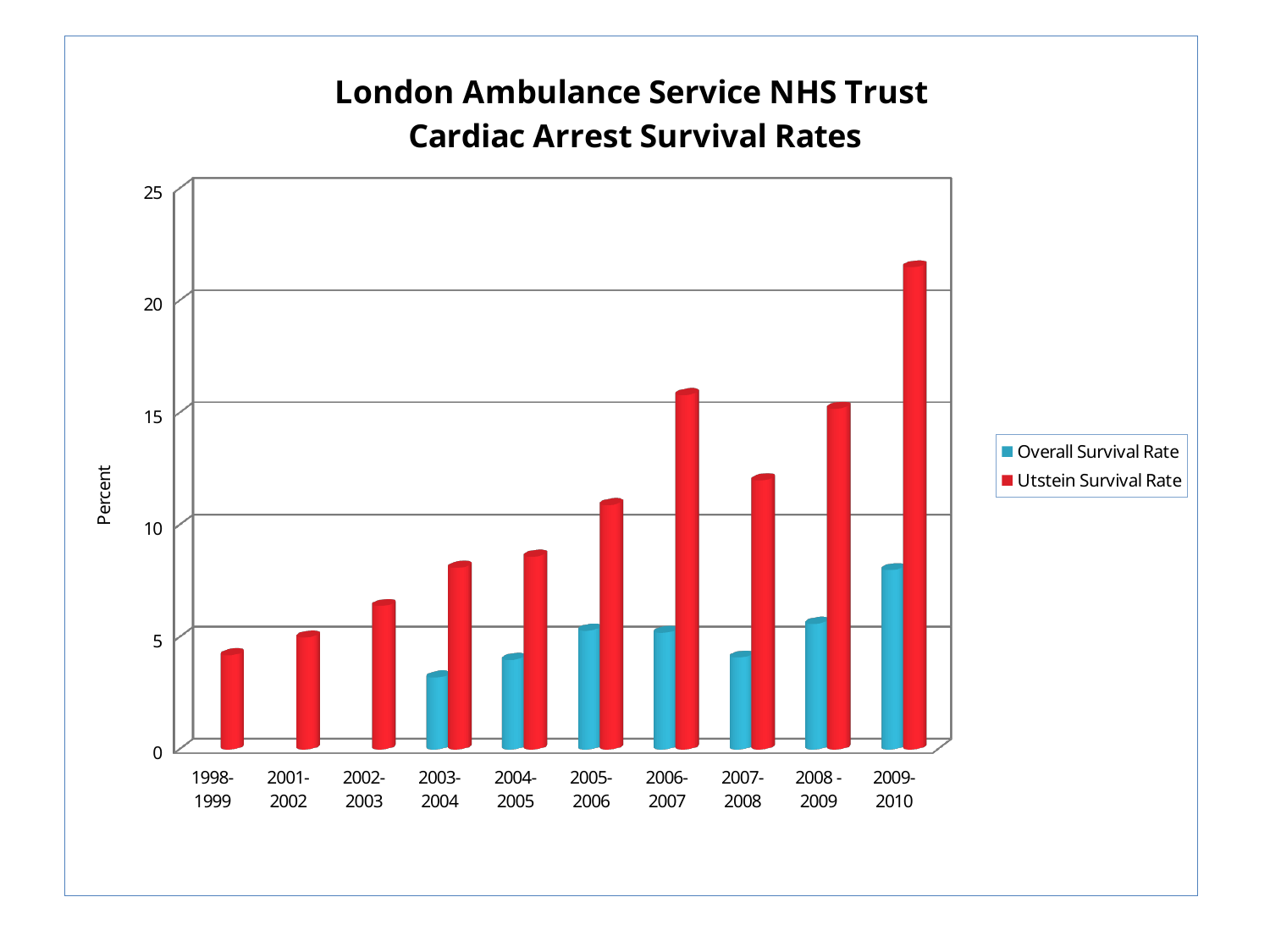
Which year period has the highest Utstein Survival Rate? 2009-2010 What kind of chart is shown on the slide? Bar chart Which is larger, the Utstein Survival Rate for 2006-2007 or for 2007-2008? 2006-2007 Is the Overall Survival Rate for 2009-2010 greater or less than 10? less Which year period has the lowest Overall Survival Rate among those with an Overall Survival Rate bar? 2003-2004 Which year period has the lowest Utstein Survival Rate? 1998-1999 Which year period has the highest Overall Survival Rate? 2009-2010 What colour represents the Utstein Survival Rate in the legend? Red Is the Utstein Survival Rate for 2009-2010 greater or less than 20? greater How many year periods are shown on the x axis? 10 How many series does the legend list? 2 What is the label on the vertical axis? Percent